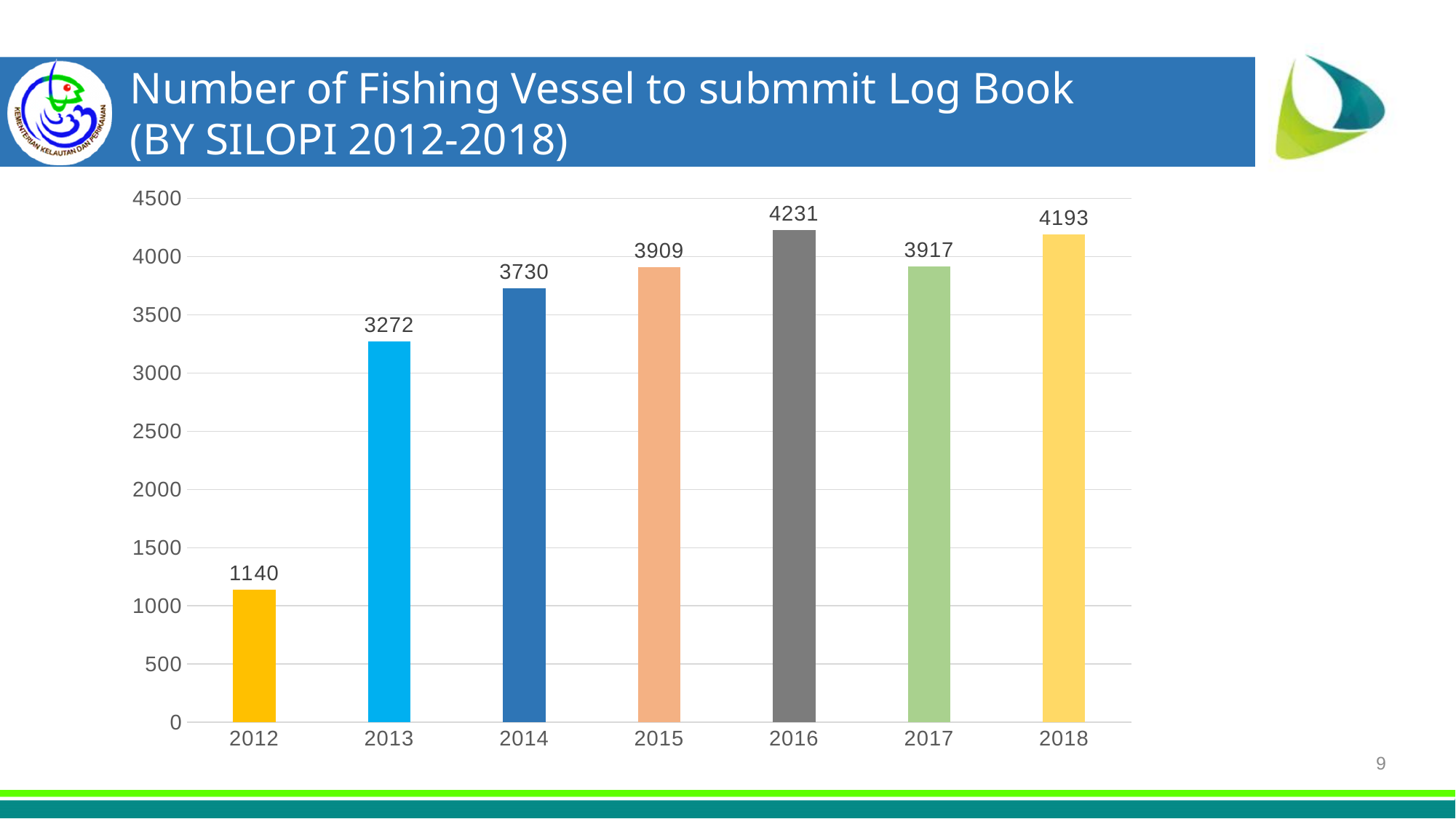
How many years are shown on the x axis of the chart? 7 Which year has the lowest number of fishing vessels submitting log books? 2012 What is the difference between the values for 2016 and 2018? 38 Is the value for 2017 greater or less than 3500? greater What is the value shown for 2016? 4231 Which year has the highest number of fishing vessels submitting log books? 2016 What is the number of fishing vessels submitting log books in 2012? 1140 What is the difference between the values for 2013 and 2012? 2132 What is the value shown for 2018? 4193 Which year has a larger value, 2014 or 2015? 2015 What is the title of the chart on the slide? Number of Fishing Vessel to submmit Log Book (BY SILOPI 2012-2018) What kind of chart is shown on the slide? bar chart